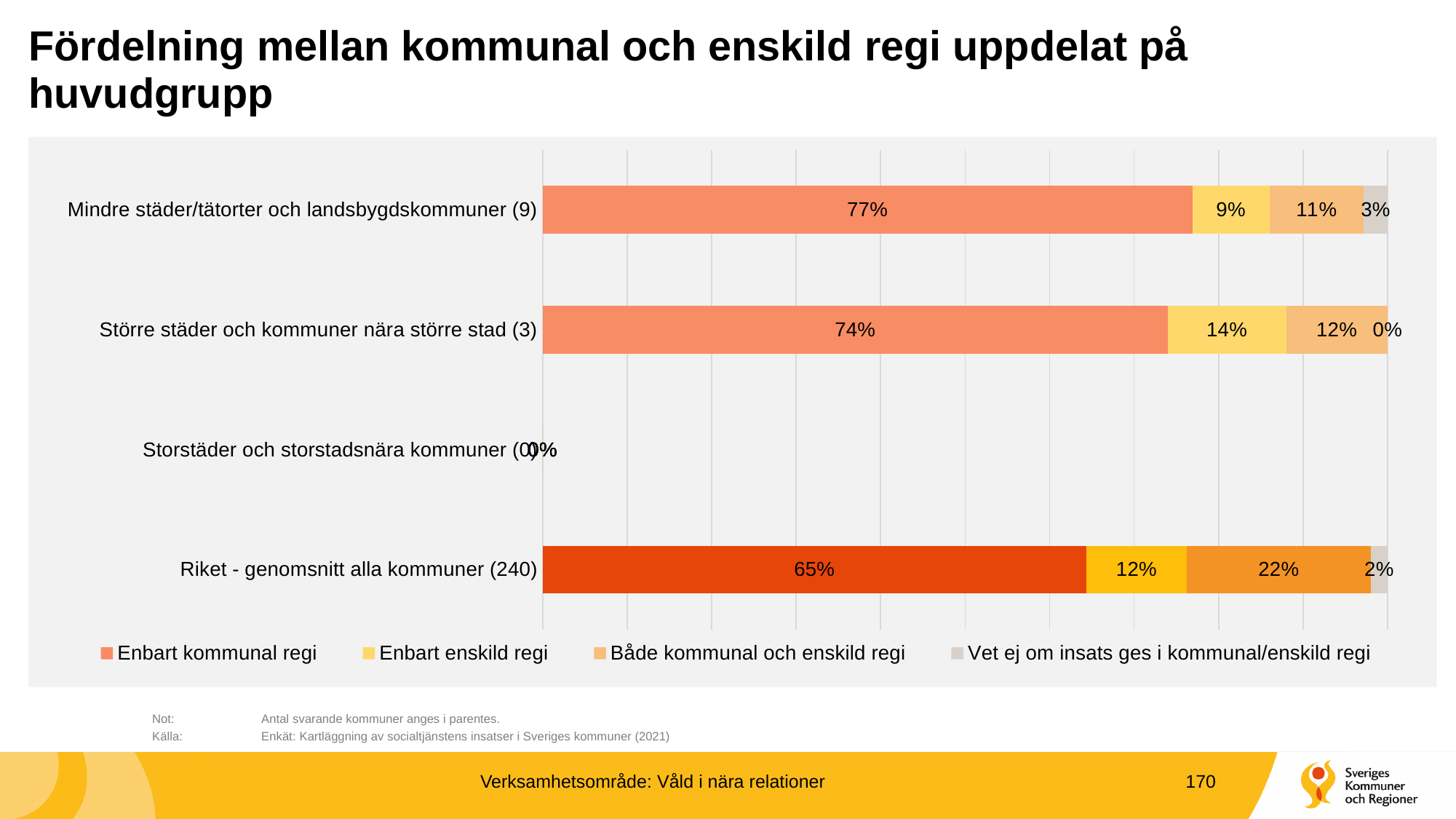
Which category has the highest value for "Både kommunal och enskild regi"? Riket - genomsnitt alla kommuner (240) What is the value of "Enbart enskild regi" for "Större städer och kommuner nära större stad (3)"? 14% How many series does the legend list? 4 What kind of chart is shown on the slide? Stacked bar chart What is the total of the stacked bar for "Riket - genomsnitt alla kommuner (240)"? 101% What is the value of "Vet ej om insats ges i kommunal/enskild regi" for "Mindre städer/tätorter och landsbygdskommuner (9)"? 3% What is the difference between the "Enbart kommunal regi" values for "Mindre städer/tätorter och landsbygdskommuner (9)" and "Riket - genomsnitt alla kommuner (240)"? 12% Which category has the highest value for "Enbart kommunal regi"? Mindre städer/tätorter och landsbygdskommuner (9) Which is larger: "Enbart enskild regi" for "Större städer och kommuner nära större stad (3)" or for "Riket - genomsnitt alla kommuner (240)"? Större städer och kommuner nära större stad (3) How many categories are shown on the y axis of the chart? 4 What is the value of "Både kommunal och enskild regi" for "Riket - genomsnitt alla kommuner (240)"? 22% What is the value of "Enbart kommunal regi" for "Mindre städer/tätorter och landsbygdskommuner (9)"? 77%